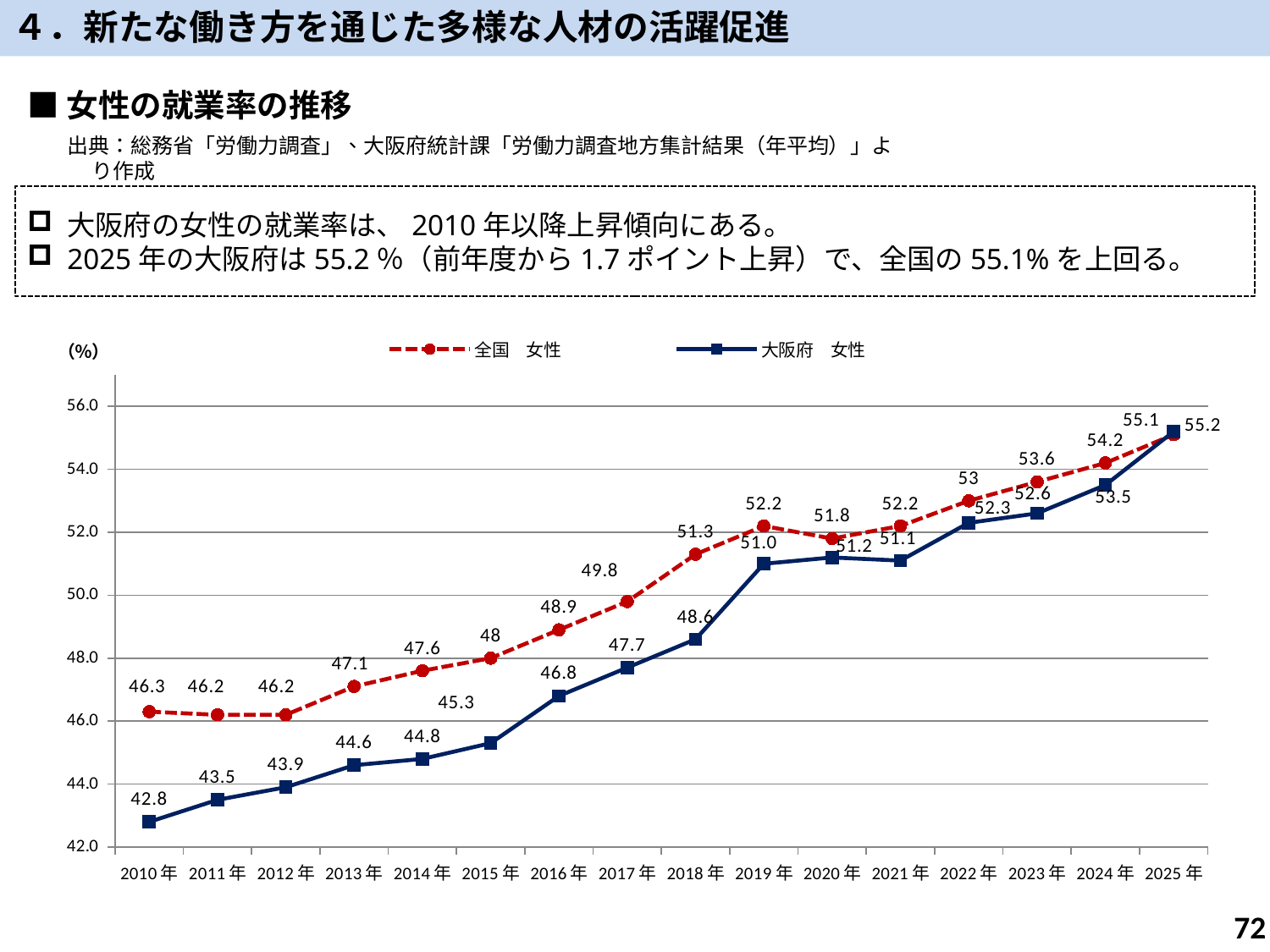
Which series is drawn with a red dashed line? 全国 女性 What is the value for 大阪府 女性 in 2010年? 42.8 What is the value for 全国 女性 in 2019年? 52.2 How many years are plotted along the x axis? 16 In which year is the 全国 女性 value highest? 2025年 How many series does the legend list? 2 What is the value for 大阪府 女性 in 2025年? 55.2 What is the difference between the 全国 女性 and 大阪府 女性 values in 2016年? 2.1 In which year is the 大阪府 女性 value lowest? 2010年 Which is larger in 2025年, the 全国 女性 value or the 大阪府 女性 value? 大阪府 女性 Does the 大阪府 女性 series generally rise or fall from 2010年 to 2025年? rise What type of chart is shown on the slide? line chart